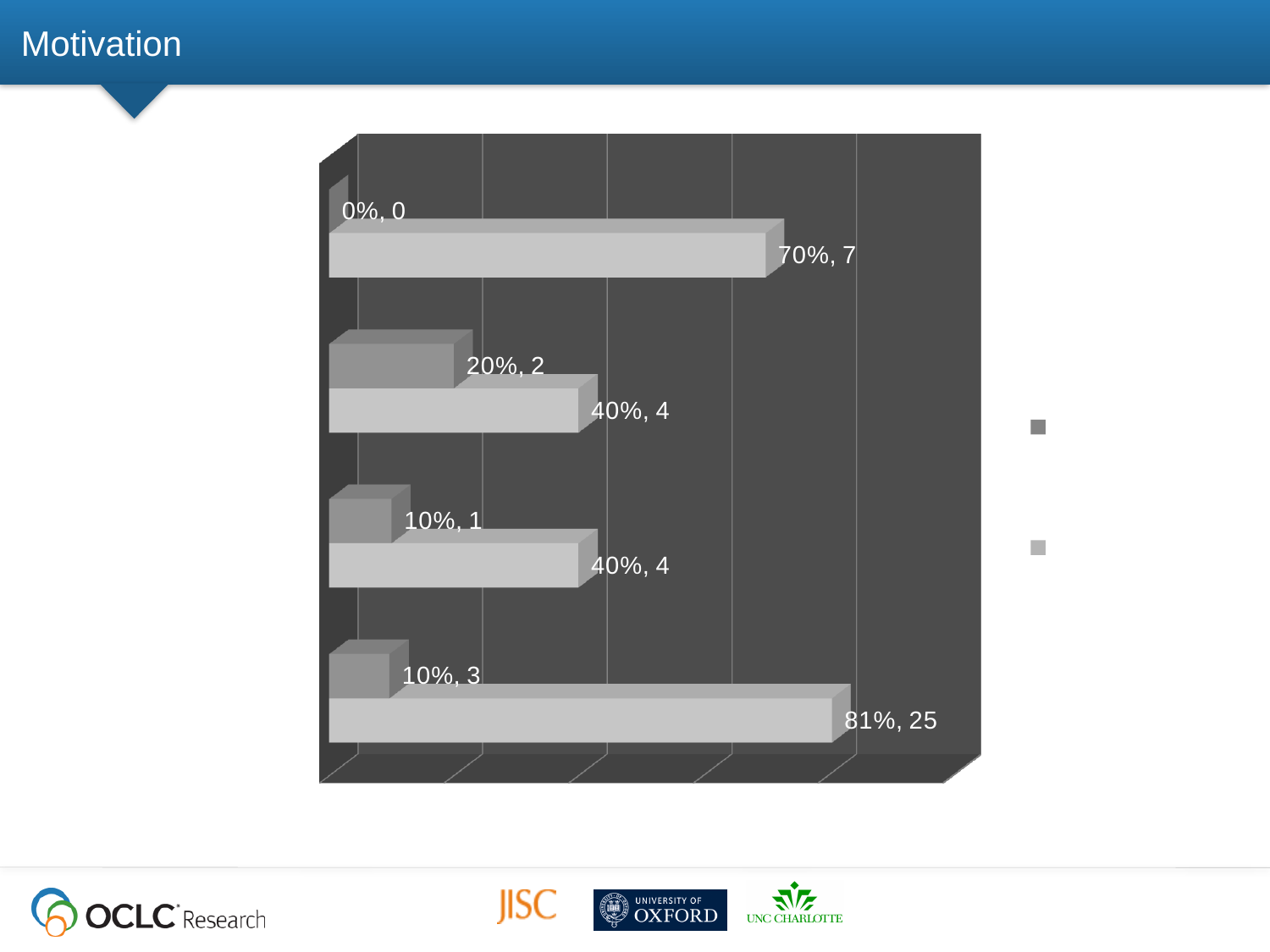
What is the data label on the darker bar in the top group? 0%, 0 Which is larger: the lighter bar in the top group or the lighter bar in the bottom group? the lighter bar in the bottom group In the third group from the top, what is the difference in percentage between the lighter bar and the darker bar? 30% Which bar has the lowest value on the chart? the darker bar in the top group (0%, 0) What is the data label on the lighter bar in the top group? 70%, 7 In the bottom group, what is the difference in count between the lighter bar and the darker bar? 22 Which bar has the highest value on the chart? the lighter bar in the bottom group (81%, 25) What kind of chart is shown on the slide? bar chart What is the data label on the darker bar in the second group from the top? 20%, 2 What is the data label on the lighter bar in the bottom group? 81%, 25 How many series markers does the chart's legend show? 2 How many groups of bars (categories) does the chart show? 4